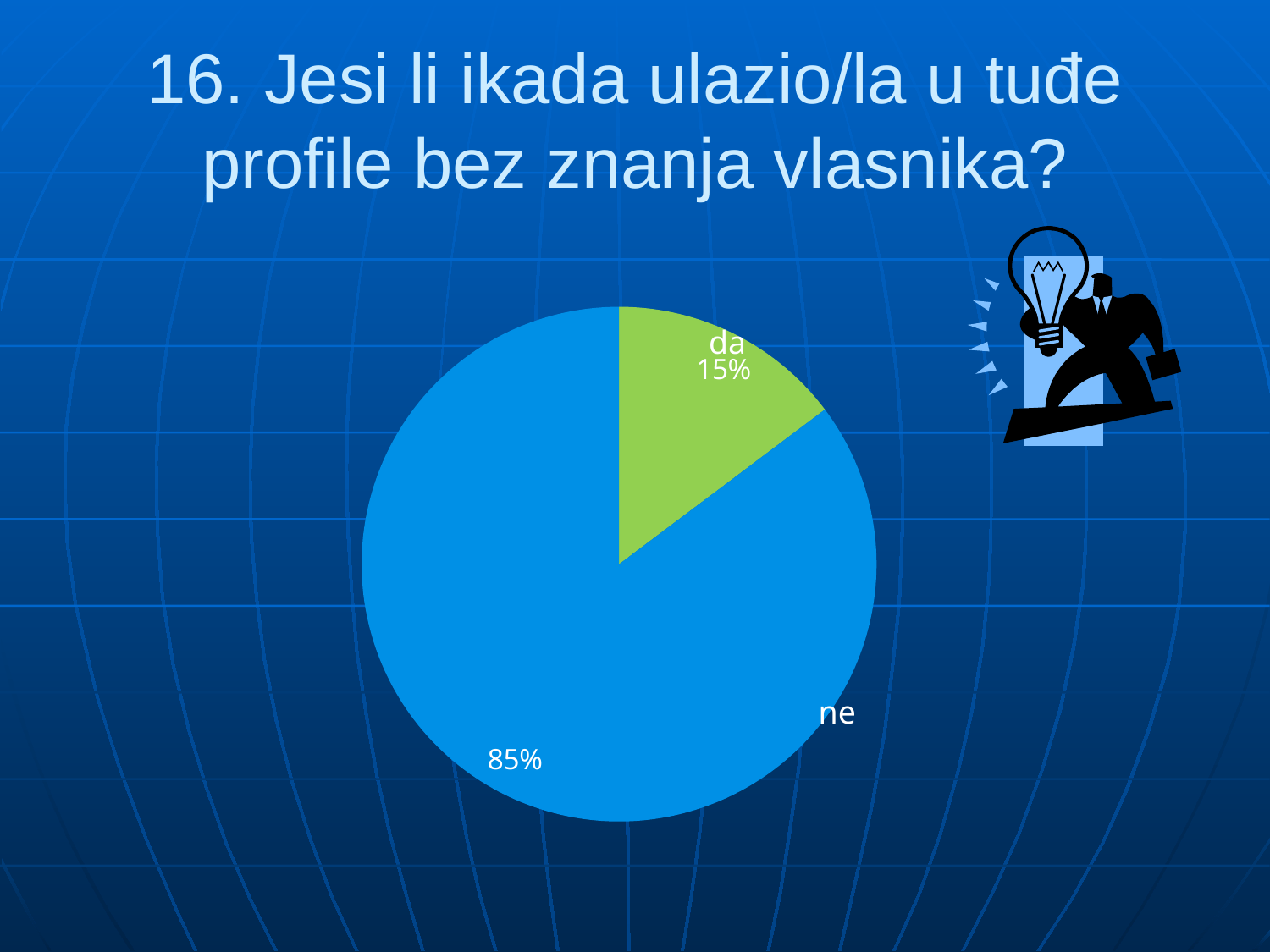
Which slice of the pie is the smallest? da What kind of chart is shown on the slide? pie chart What share of the pie does the "ne" slice represent? 85% What is the title of the slide containing the pie chart? 16. Jesi li ikada ulazio/la u tuđe profile bez znanja vlasnika? How many slices does the pie chart have? 2 What colour is the "da" slice of the pie? green Which slice of the pie is the largest? ne What percentage of the pie is labelled "da"? 15% What percentage of the pie is labelled "ne"? 85% Which is larger, the "da" slice or the "ne" slice? ne What is the difference in percentage points between the "ne" slice and the "da" slice? 70